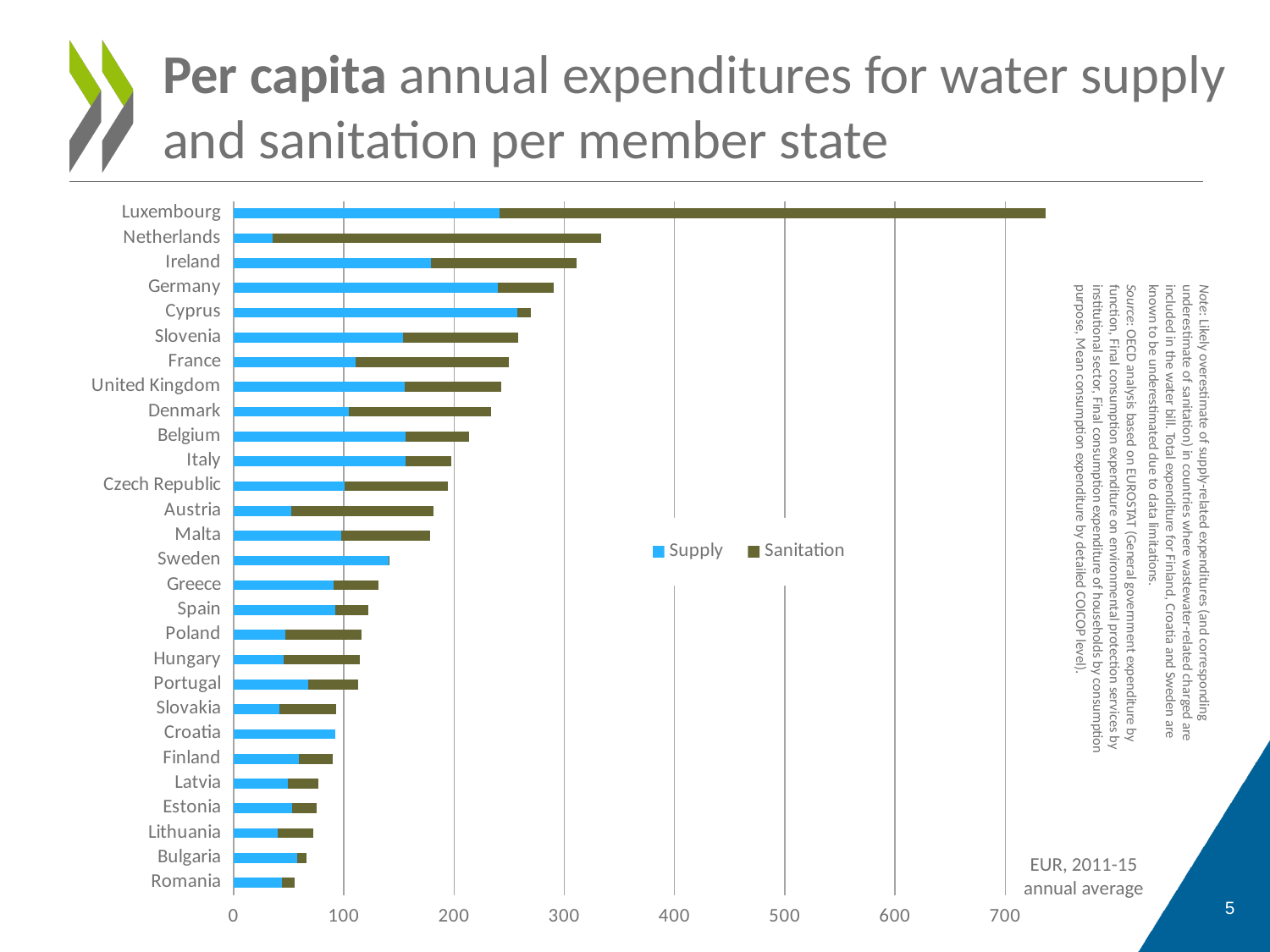
Is the total value for Luxembourg greater or less than 700? greater What are the two series named in the legend? Supply and Sanitation How many series does the legend list? 2 Which member state has the lowest total per capita expenditure? Romania Is the total value for Romania greater or less than 100? less What kind of chart is shown on the slide? bar chart Which member state has the highest total per capita expenditure? Luxembourg Is the Supply value for Netherlands greater or less than 100? less Which has the larger total expenditure, Luxembourg or Netherlands? Luxembourg How many member states (categories) are plotted in the chart? 28 Which has the larger Supply value, Germany or Austria? Germany